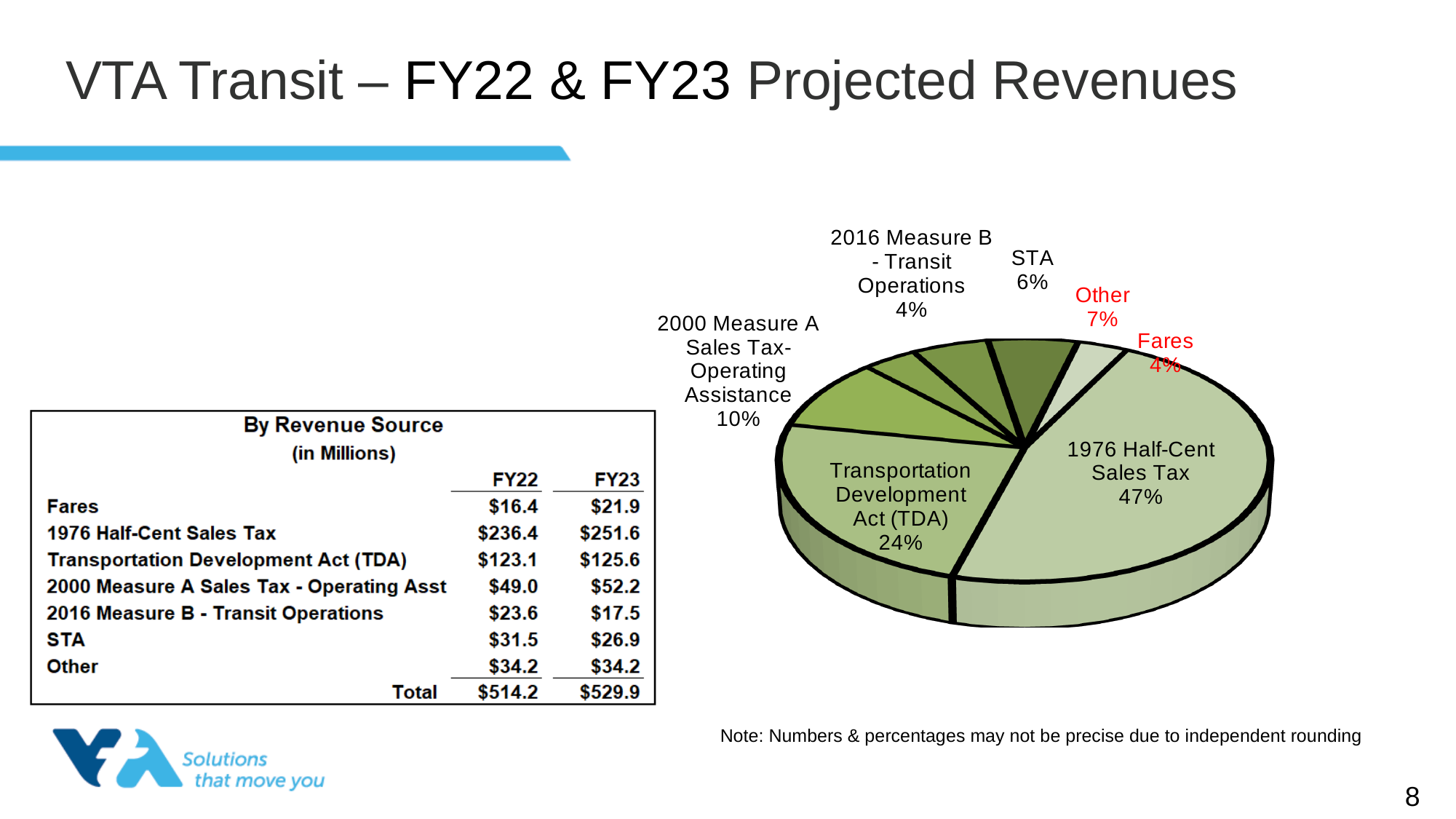
What percentage is shown for STA in the pie chart? 6% Which is larger in the pie chart, STA or Other? Other Which slice of the pie chart is the largest? 1976 Half-Cent Sales Tax What is the difference in percentage points between 1976 Half-Cent Sales Tax and Transportation Development Act (TDA) in the pie chart? 23 How many slices does the pie chart have? 7 What percentage is shown for 2000 Measure A Sales Tax-Operating Assistance in the pie chart? 10% Which two slice labels in the pie chart are printed in red text? Other and Fares What percentage is shown for Transportation Development Act (TDA) in the pie chart? 24% What kind of chart is shown on the slide? Pie chart What percentage is shown for Fares in the pie chart? 4% What percentage is shown for Other in the pie chart? 7% What share of the pie chart does 1976 Half-Cent Sales Tax represent? 47%